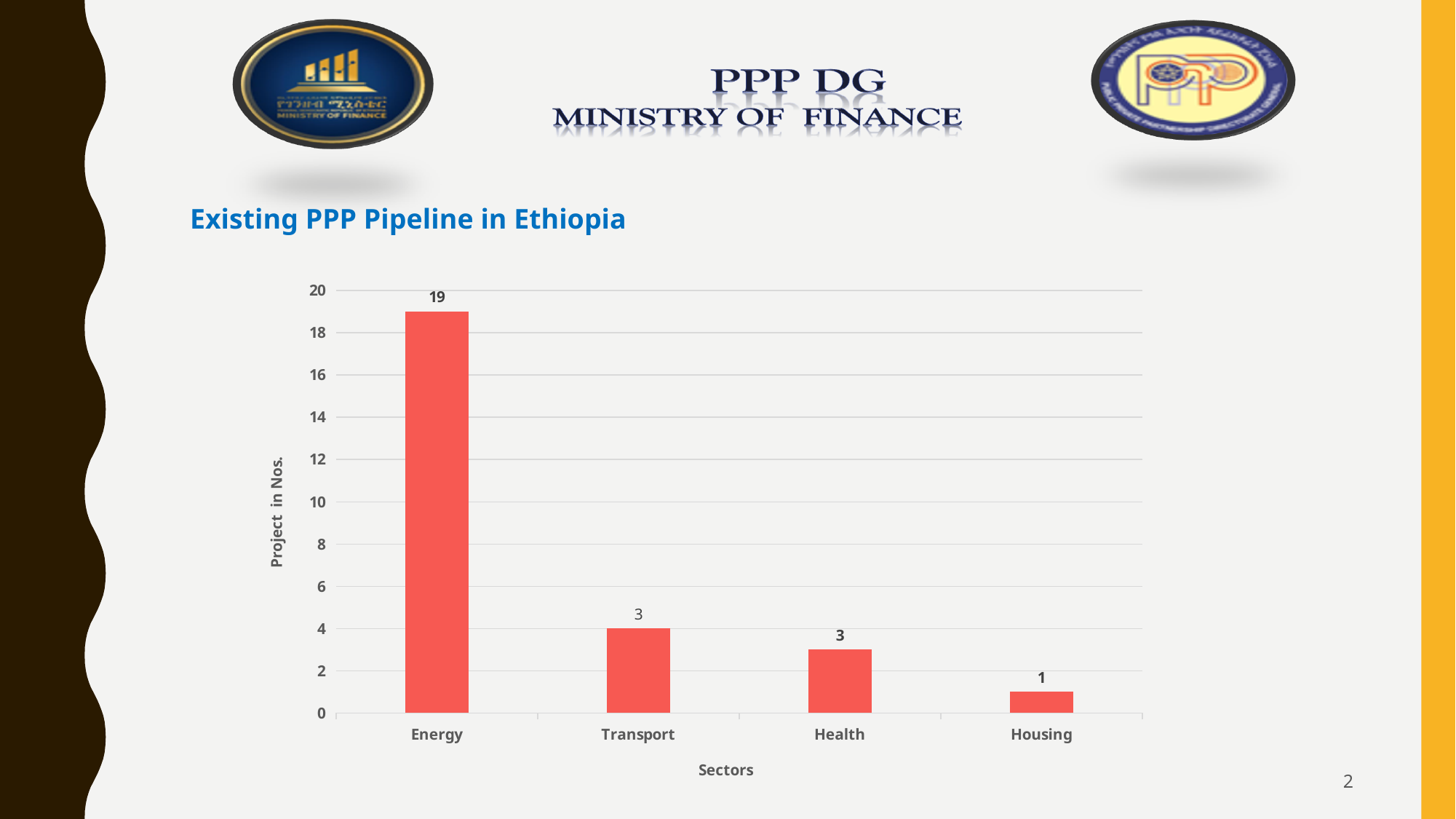
How many projects are in the pipeline for the Energy sector? 19 Which sector has the highest number of projects? Energy What is the difference between the Health and Housing values? 2 What is the difference between the Energy and Health values? 16 Is the value for Energy greater or less than 10? greater What kind of chart is shown on the slide? Bar chart What is the value shown for the Health sector? 3 Which sector has the lowest number of projects? Housing How many sectors are shown on the x axis? 4 What is the title of the vertical axis? Project in Nos. Which is larger, the value for Energy or the value for Health? Energy What is the value shown for the Housing sector? 1